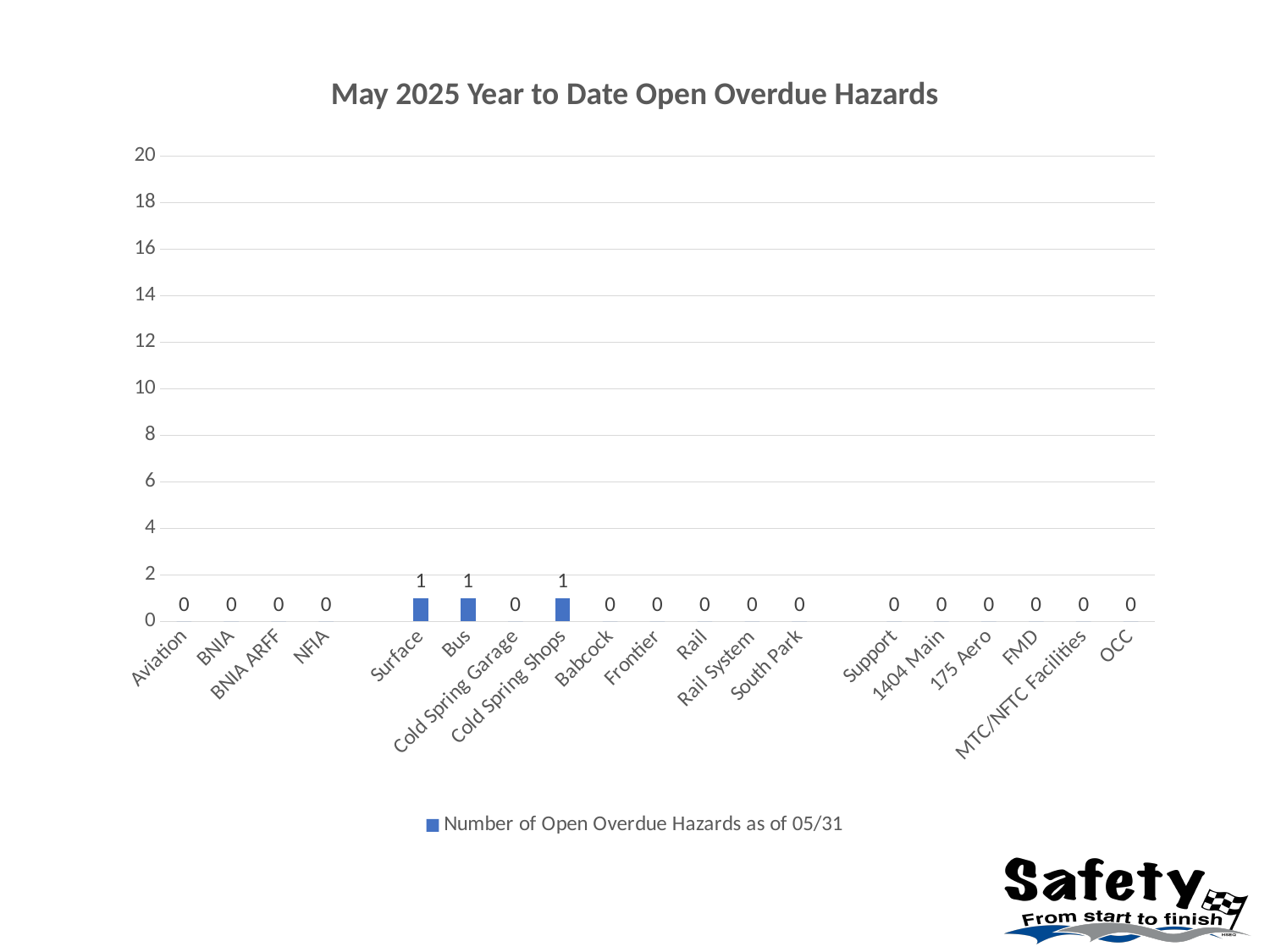
Which is larger, the value for Surface or the value for Babcock? Surface What is the value for Cold Spring Shops? 1 What kind of chart is shown on the slide? Bar chart What is the value for Cold Spring Garage? 0 How many categories are shown on the x axis? 19 What is the value for Aviation? 0 How many series does the legend list? 1 What is the value for Bus? 1 What is the highest value shown on the chart? 1 What is the value for Surface? 1 What is the title of the chart? May 2025 Year to Date Open Overdue Hazards What is the difference between the value for Bus and the value for Frontier? 1